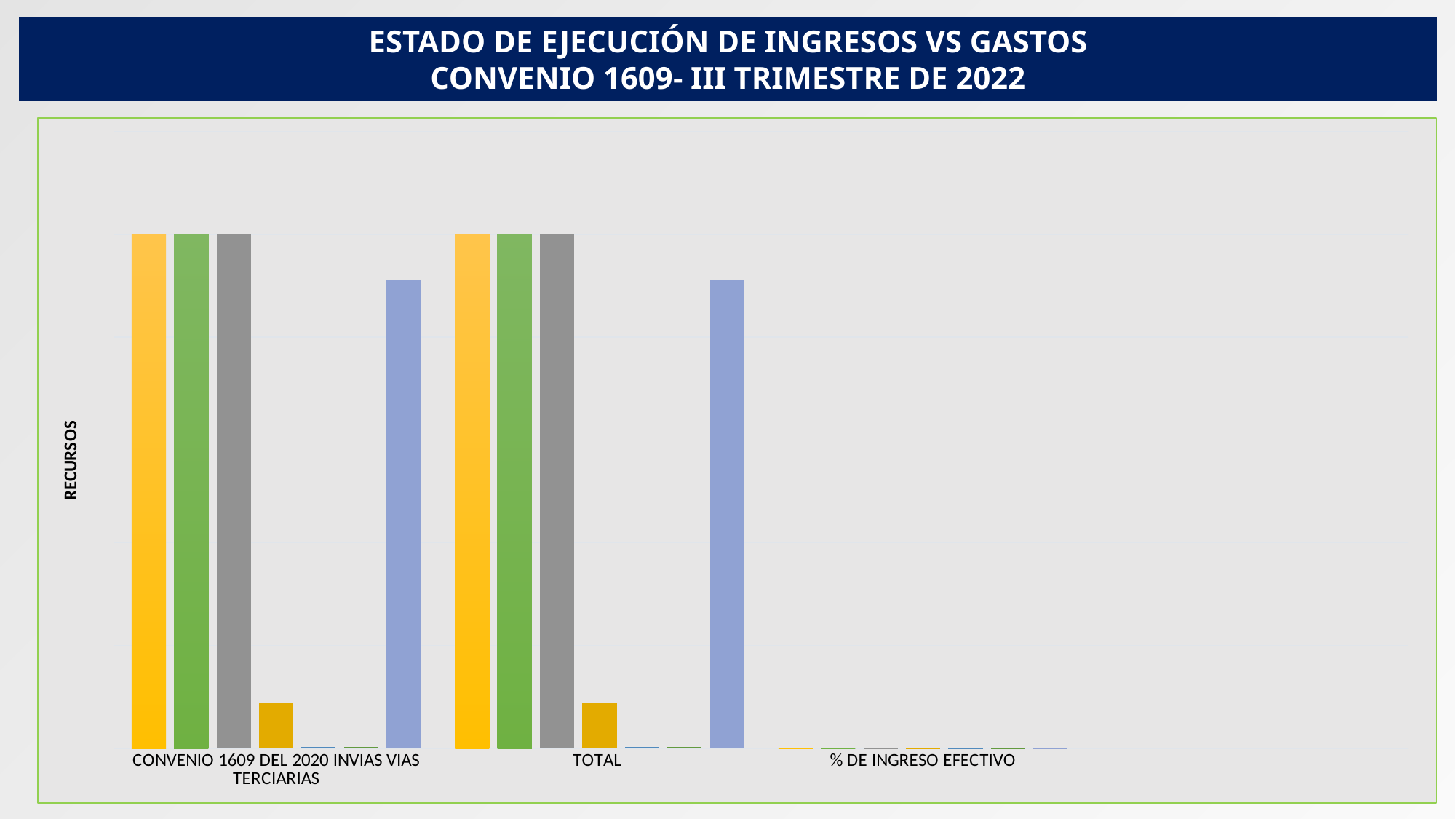
How many categories are shown on the x axis of the chart? 3 What is the title shown above the chart? ESTADO DE EJECUCIÓN DE INGRESOS VS GASTOS CONVENIO 1609- III TRIMESTRE DE 2022 Which category has the smallest bars in the chart? % DE INGRESO EFECTIVO What kind of chart is shown on the slide? bar chart In the CONVENIO 1609 DEL 2020 INVIAS VIAS TERCIARIAS category, is the yellow bar taller or shorter than the blue bar? taller What is the label on the vertical axis of the chart? RECURSOS In the TOTAL category, is the dark gold bar taller or shorter than the blue bar? shorter In the TOTAL category, is the green bar taller or shorter than the blue bar? taller